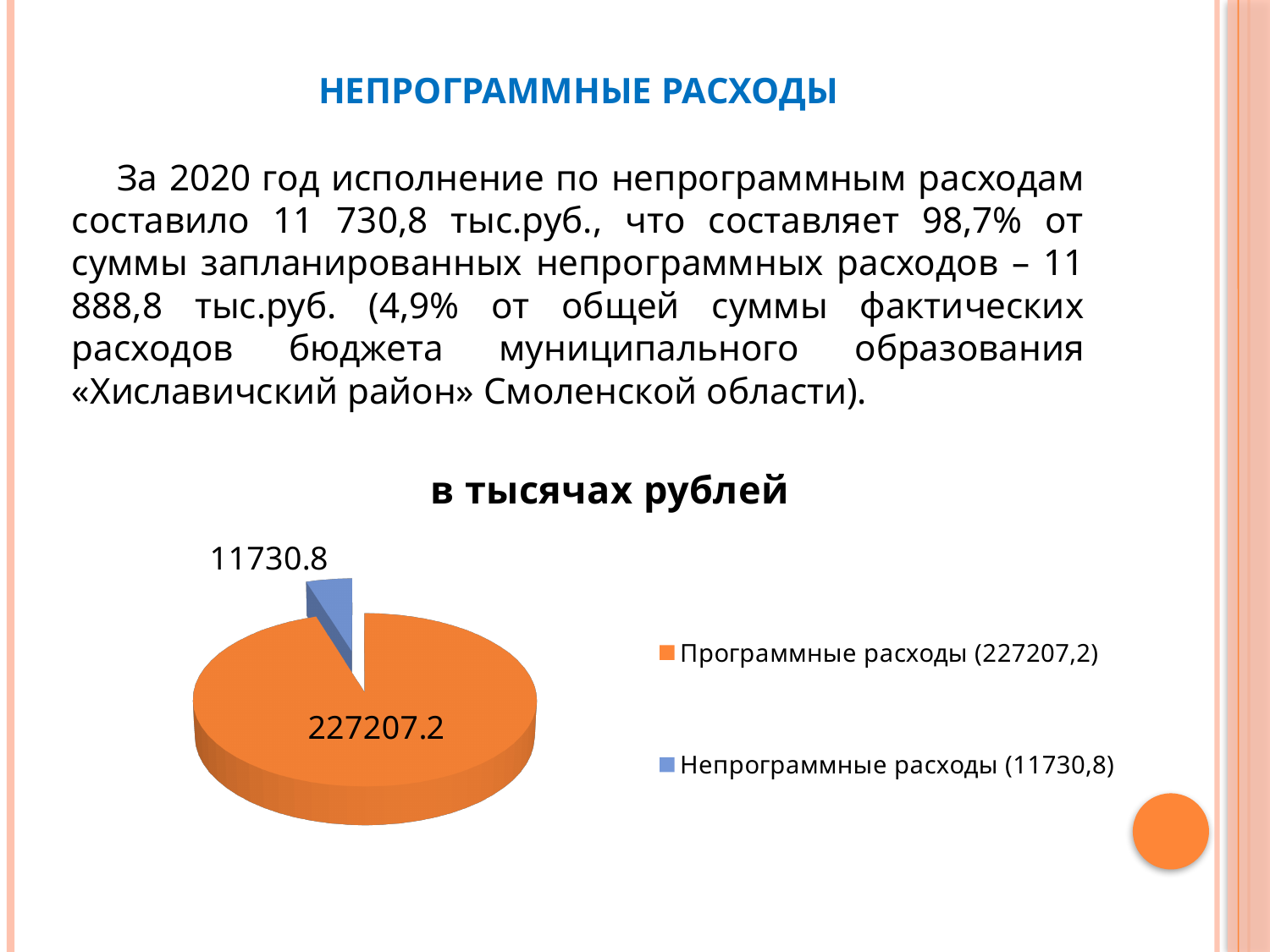
Which category has the smallest slice in the pie chart? Непрограммные расходы Which is larger, Программные расходы or Непрограммные расходы? Программные расходы What is the title of the chart? в тысячах рублей What is the value for Непрограммные расходы in the pie chart? 11730.8 Which category has the largest slice in the pie chart? Программные расходы What colour is the slice for Непрограммные расходы? blue What is the total of the two slices in the pie chart? 238938.0 What is the difference between Программные расходы and Непрограммные расходы? 215476.4 What is the value for Программные расходы in the pie chart? 227207.2 How many entries does the chart legend list? 2 How many slices does the pie chart have? 2 What kind of chart is shown on the slide? pie chart